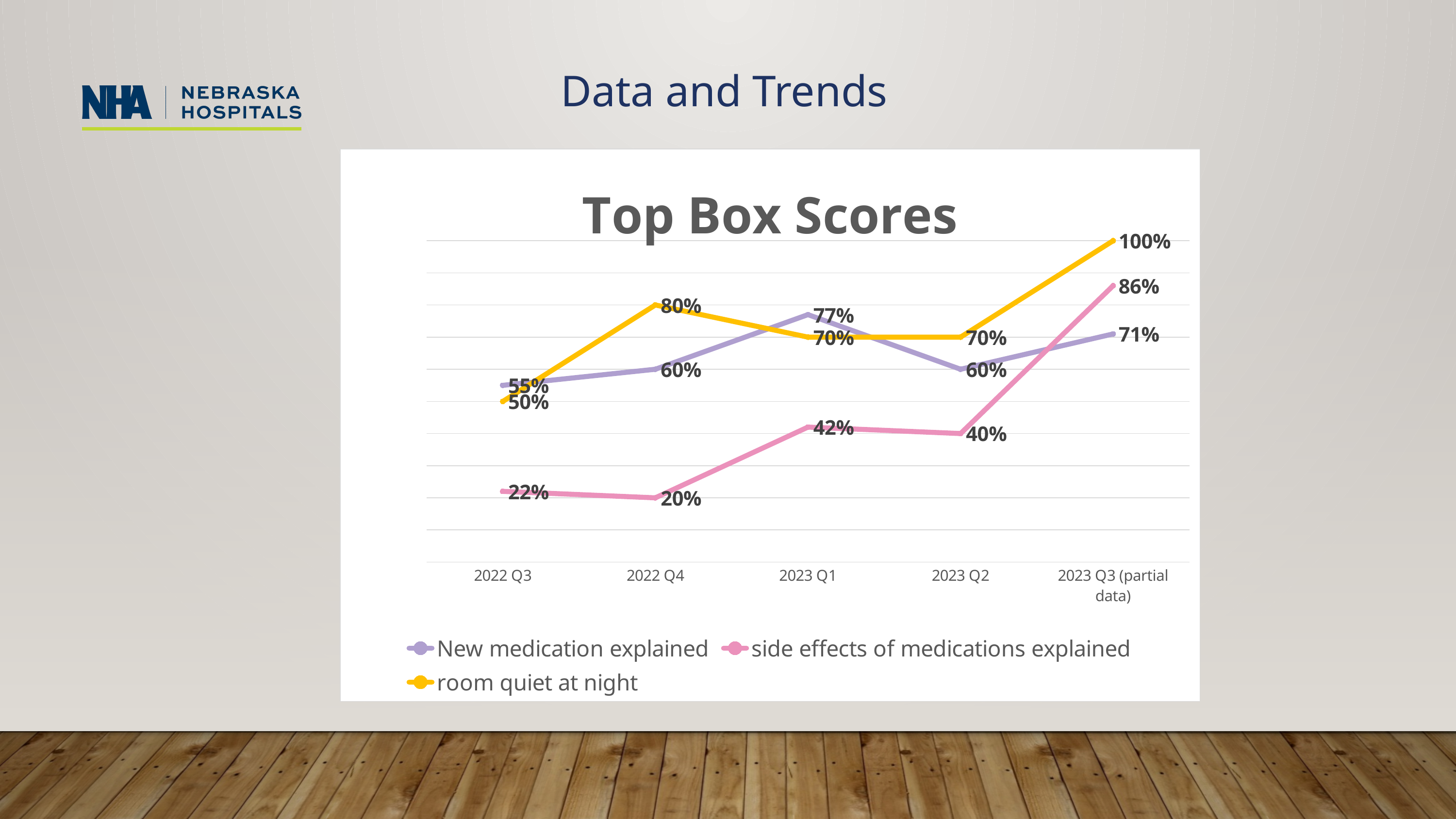
What is the value for 'side effects of medications explained' in 2022 Q4? 20% What is the value for 'New medication explained' in 2023 Q1? 77% Does 'side effects of medications explained' rise or fall from 2023 Q2 to 2023 Q3 (partial data)? Rise What is the difference between 'side effects of medications explained' in 2023 Q3 (partial data) and in 2023 Q2? 46% What is the value for 'room quiet at night' in 2022 Q3? 50% What type of chart is shown on the slide? Line chart What is the value for 'room quiet at night' in 2023 Q3 (partial data)? 100% In which quarter does 'New medication explained' reach its highest value? 2023 Q1 Which is larger in 2022 Q4: 'New medication explained' or 'room quiet at night'? room quiet at night How many series does the legend list? 3 How many quarters are shown on the x axis? 5 In which quarter is 'side effects of medications explained' at its lowest value? 2022 Q4